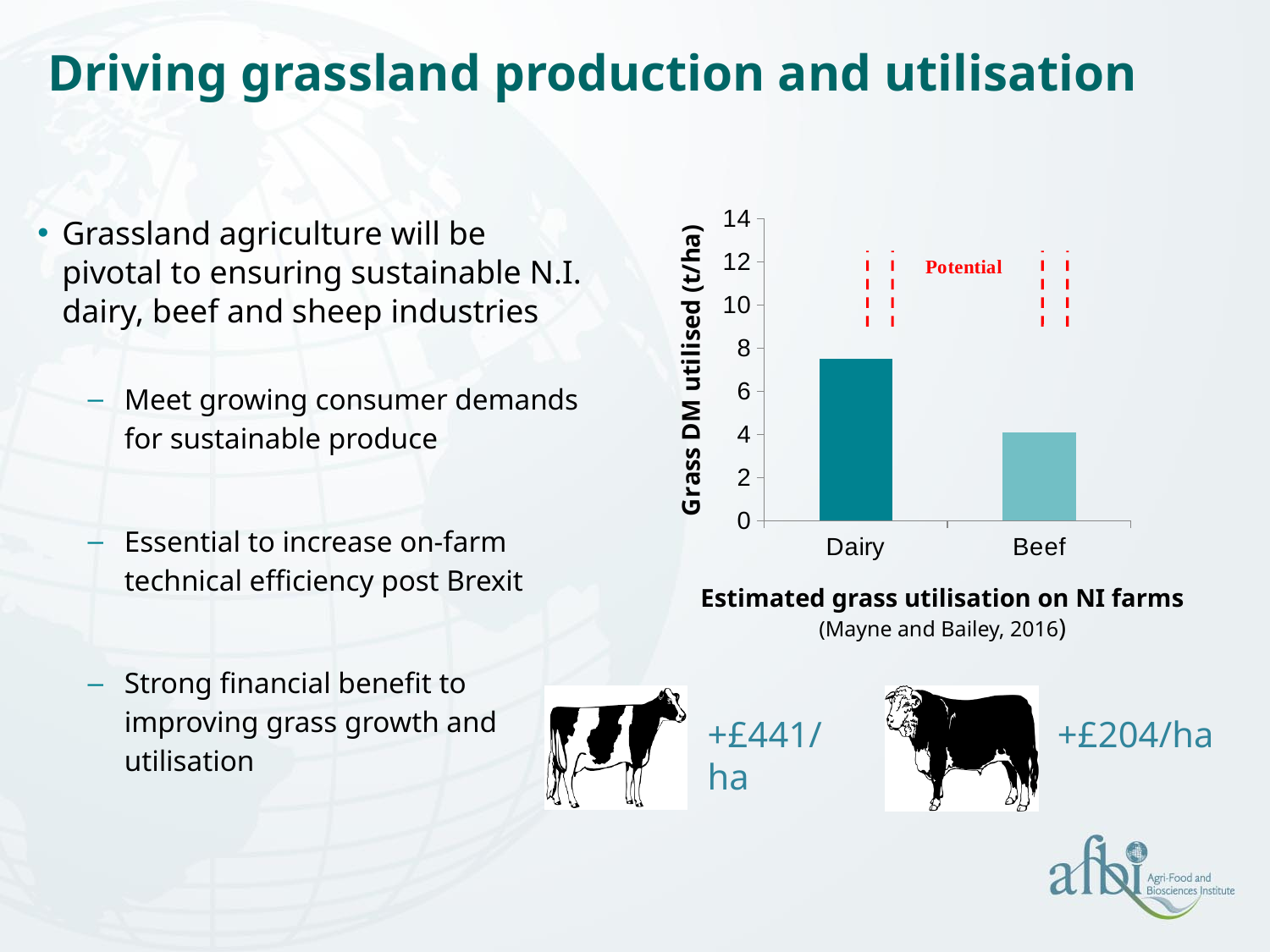
How many categories are plotted on the x axis of the chart? 2 Is the value for Dairy greater or less than 8? less Which category has the lowest grass DM utilised? Beef What kind of chart is shown on the slide? bar chart Which category has the highest grass DM utilised? Dairy What is the title of the chart? Estimated grass utilisation on NI farms Is the value for Beef greater or less than 6? less Is the value for Dairy greater or less than 6? greater What is the label on the y axis of the chart? Grass DM utilised (t/ha) Do the bar values rise or fall moving from Dairy to Beef along the x axis? fall Which is larger, the value for Dairy or the value for Beef? Dairy